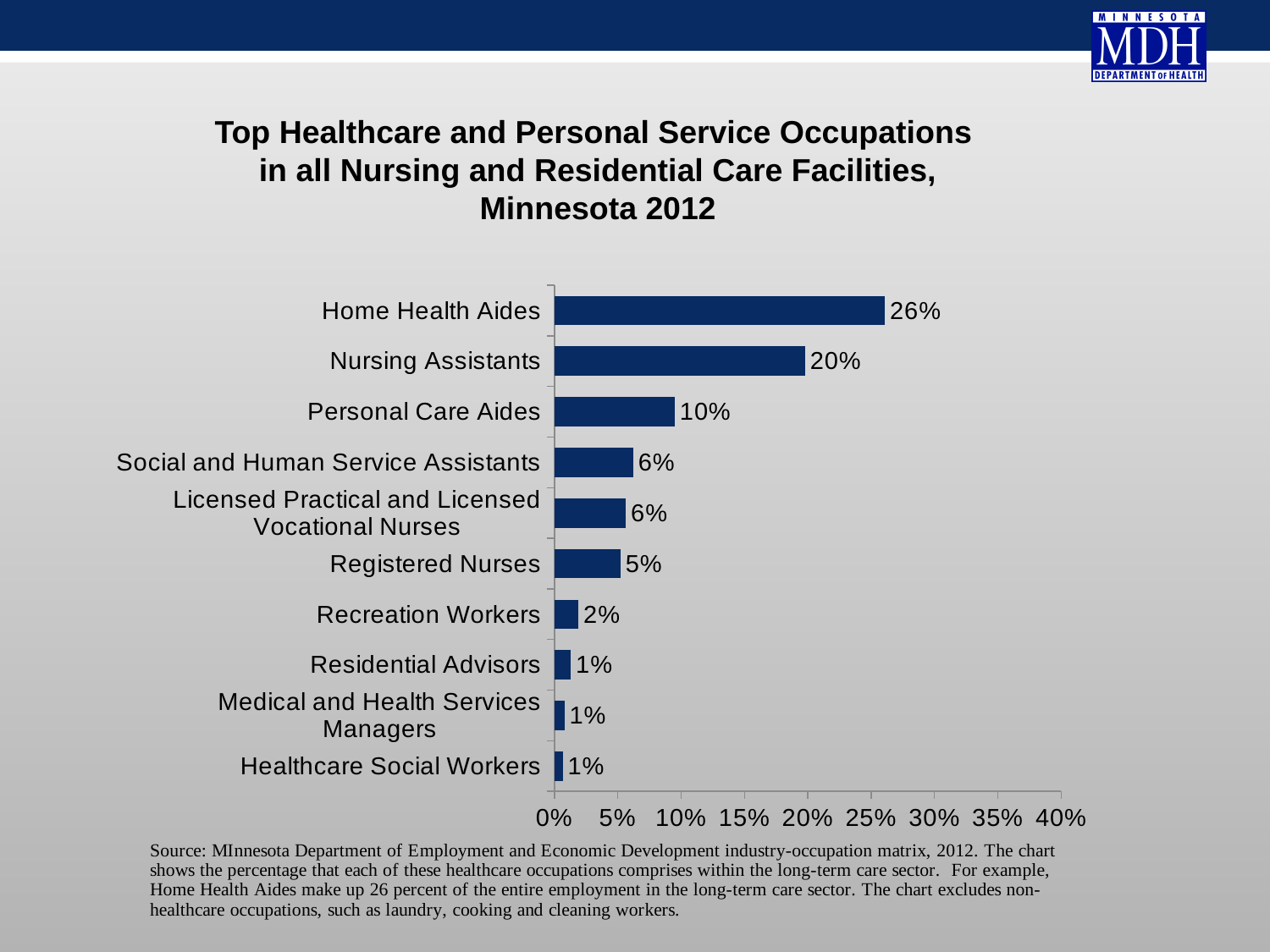
What percentage is shown for Recreation Workers? 2% How many occupations are shown in the chart? 10 Which is larger, the value for Personal Care Aides or the value for Registered Nurses? Personal Care Aides Which occupation has the highest percentage? Home Health Aides What is the difference between the percentages for Home Health Aides and Nursing Assistants? 6% Is the value for Nursing Assistants greater or less than 15%? greater What percentage is shown for Nursing Assistants? 20% What percentage is shown for Registered Nurses? 5% What is the difference between the percentages for Nursing Assistants and Personal Care Aides? 10% What percentage is shown for Home Health Aides? 26% What kind of chart is shown on the slide? Bar chart What percentage is shown for Personal Care Aides? 10%